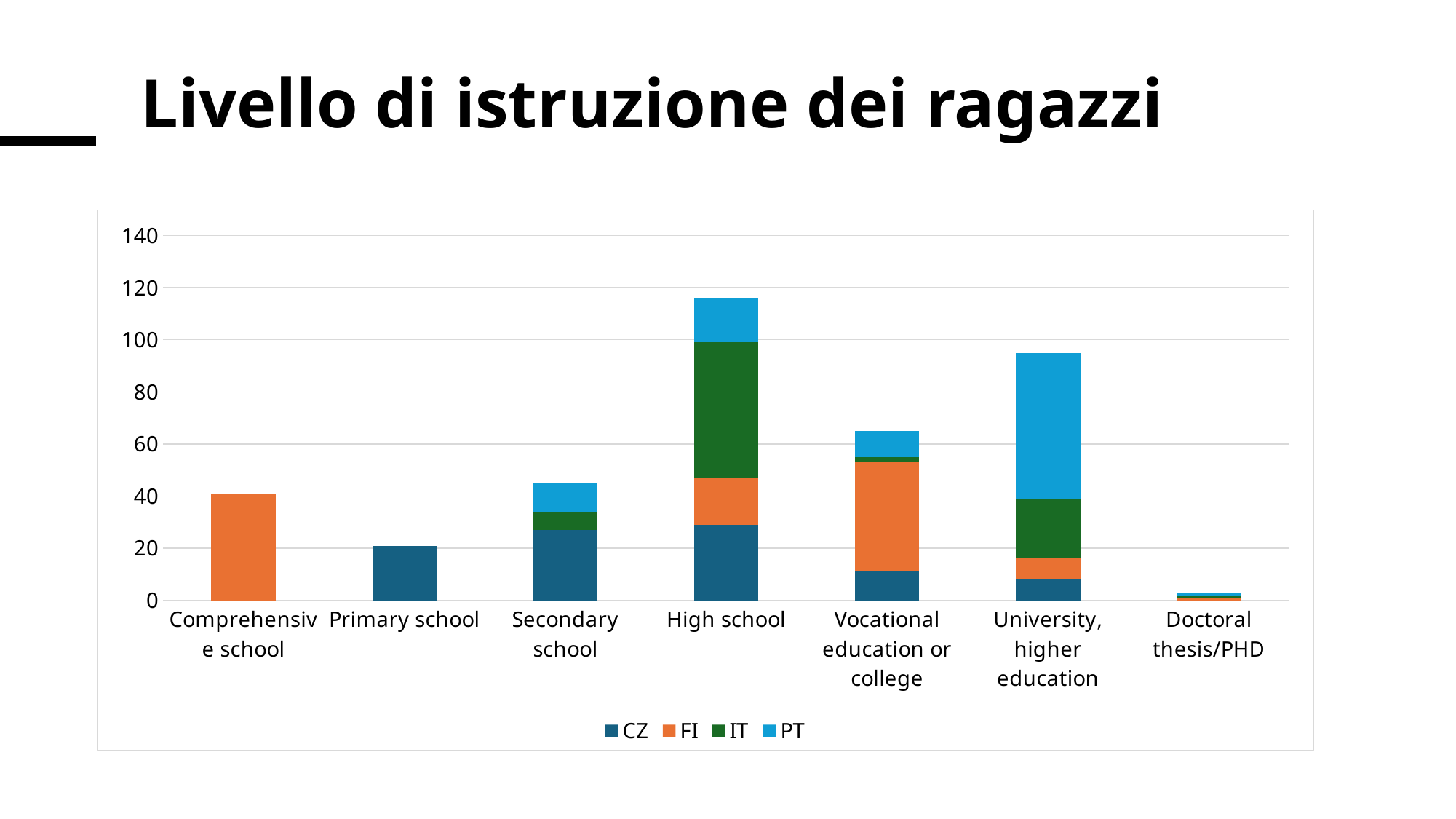
Which has a taller stacked bar overall: Comprehensive school or Primary school? Comprehensive school How many education-level categories are shown on the x axis? 7 Which series is shown in orange in the legend? FI Which category has the shortest stacked bar overall? Doctoral thesis/PHD Which category has the tallest stacked bar overall? High school Is the total stacked value for Vocational education or college greater or less than 60? greater How many series does the legend list? 4 What is the title of the slide? Livello di istruzione dei ragazzi Is the total stacked value for Primary school greater or less than 40? less Which has a taller stacked bar overall: High school or University, higher education? High school Is the total stacked value for High school greater or less than 100? greater What kind of chart is shown on the slide? Stacked bar chart